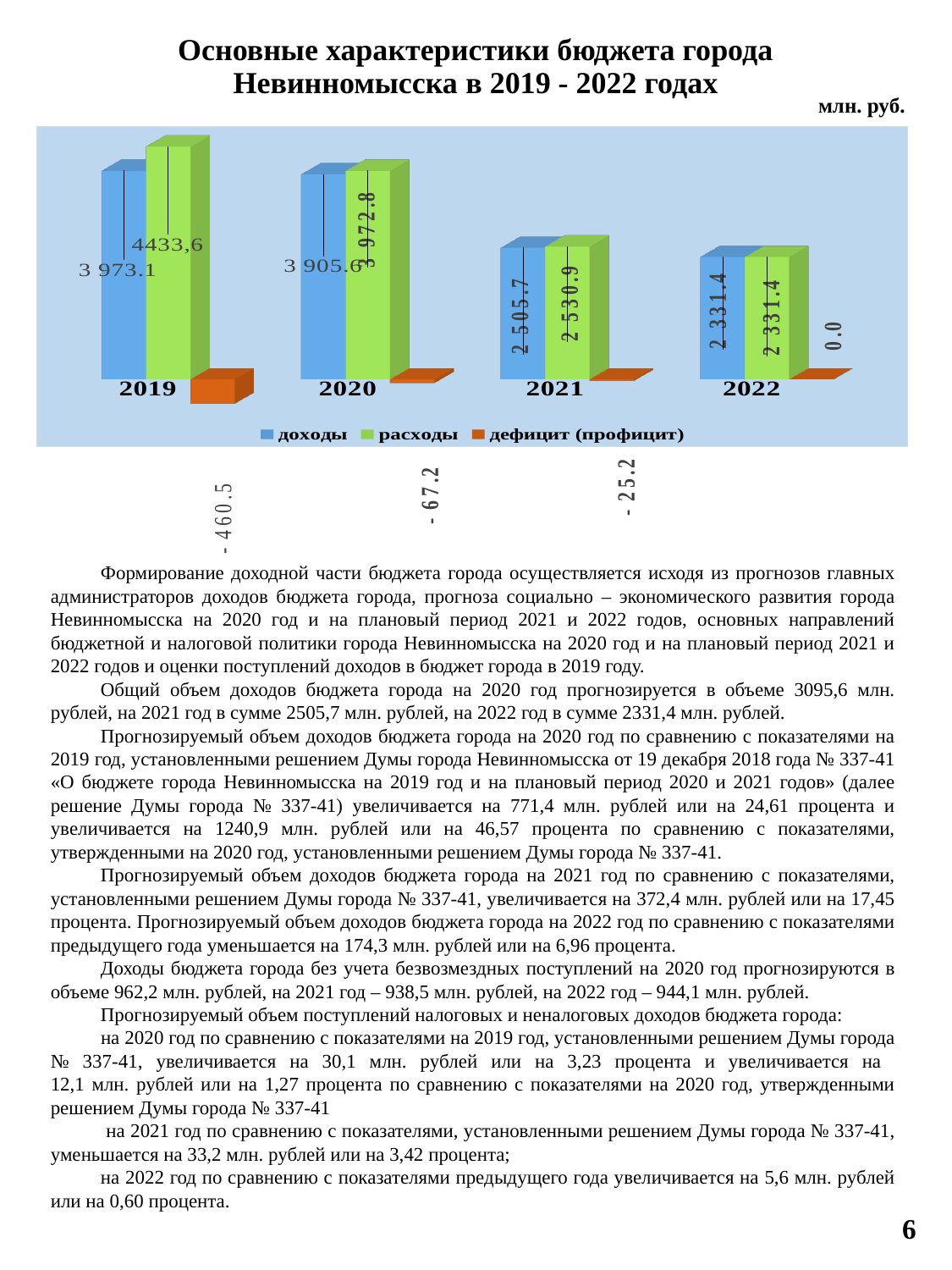
What is the value of доходы for 2019? 3 973.1 What kind of chart is shown on the slide? bar chart In 2020, which is larger: доходы or расходы? расходы Do the доходы values rise or fall from 2019 to 2022? fall What is the value of расходы for 2021? 2 530.9 What is the value of доходы for 2022? 2 331.4 What is the value of расходы for 2019? 4433,6 How many series does the legend list? 3 By how much do расходы exceed доходы in 2021? 25.2 In which year are доходы the lowest? 2022 In which year are расходы the highest? 2019 How many years are shown on the x axis? 4